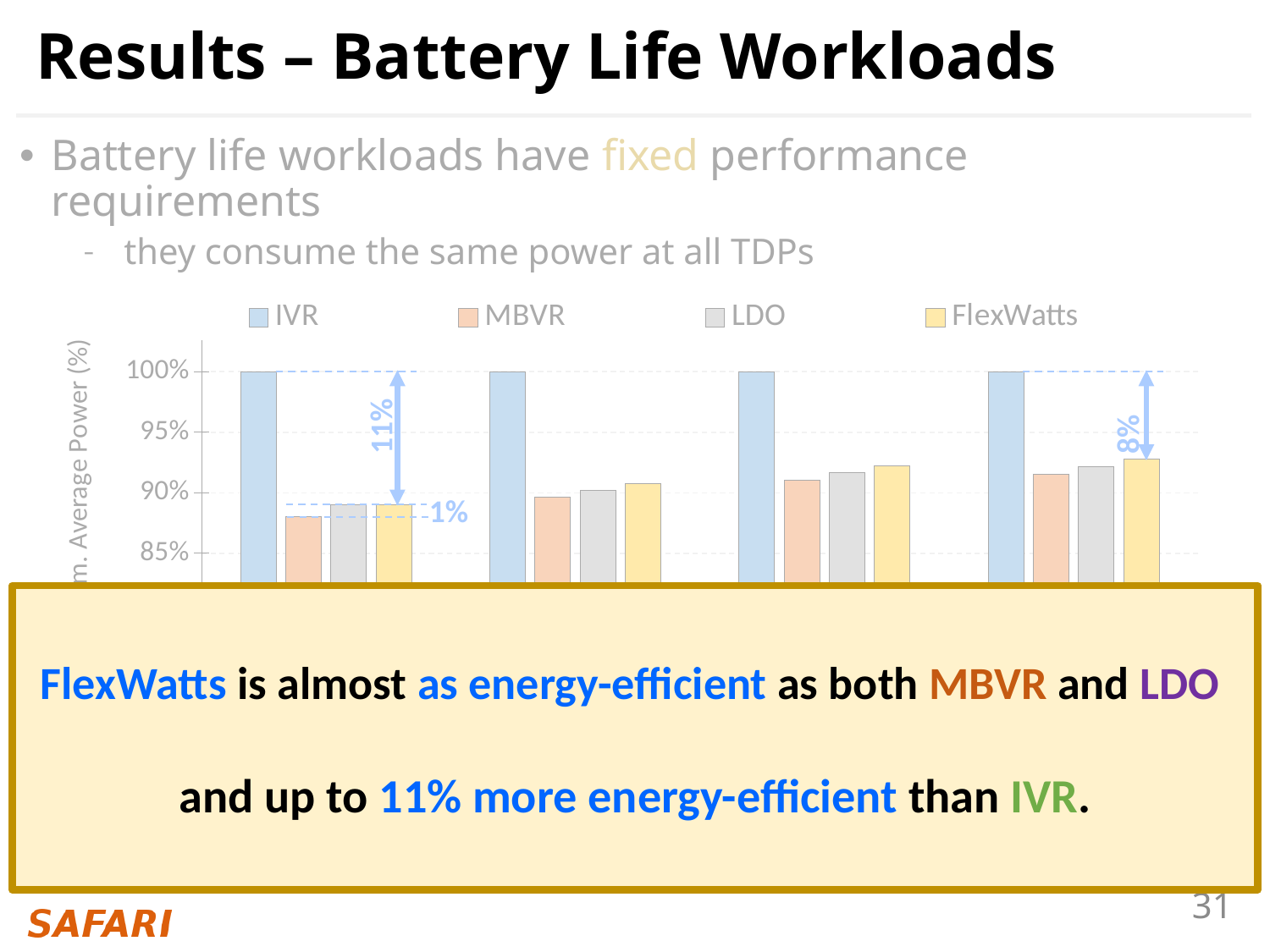
Is the FlexWatts value in the fourth (rightmost) group greater or less than 90%? greater What percentage difference is annotated between the IVR and FlexWatts bars in the fourth (rightmost) group? 8% How many series does the chart legend list? 4 What kind of chart is shown on the slide? bar chart How many groups of bars are plotted in the chart? 4 Which series has the highest bar in the first (leftmost) group? IVR What percentage difference is annotated between the IVR and FlexWatts bars in the first (leftmost) group? 11% Is the MBVR value in the first (leftmost) group greater or less than 90%? less Which series has the lowest bar in the first (leftmost) group? MBVR In the first (leftmost) group, which is larger: the IVR bar or the FlexWatts bar? IVR What is the normalized average power value of the IVR bar in the first (leftmost) group? 100% Do the FlexWatts bars rise or fall from the leftmost group to the rightmost group? rise